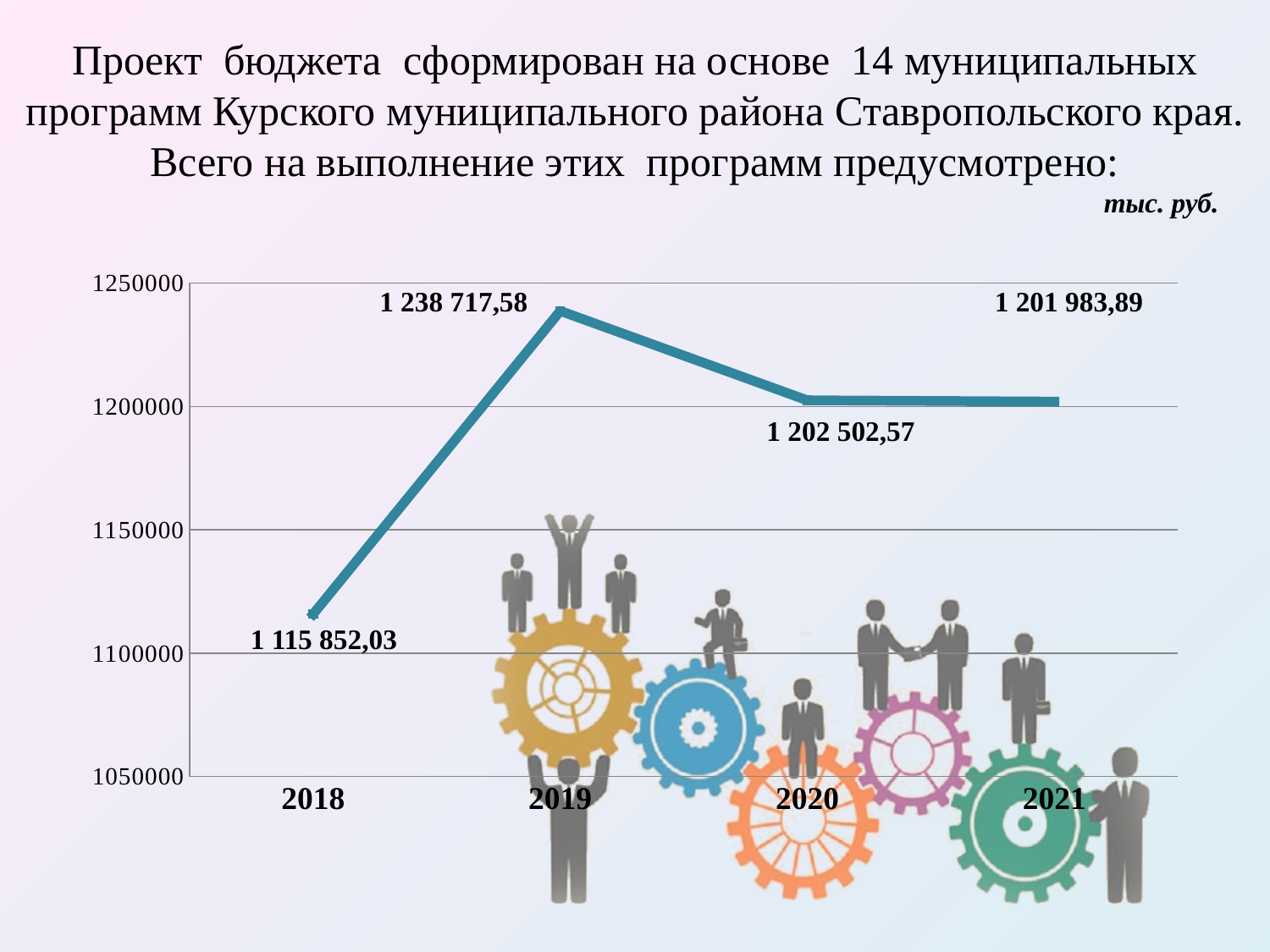
What is the value for 2021? 1 201 983,89 Which year has the lowest value? 2018 What is the value for 2020? 1 202 502,57 Which is larger, the value for 2018 or the value for 2020? 2020 What is the value for 2019? 1 238 717,58 How many years are plotted on the chart? 4 What kind of chart is shown on the slide? line chart What is the difference between the values for 2020 and 2021? 518,68 Which year has the highest value? 2019 What is the difference between the values for 2019 and 2018? 122 865,55 Is the value for 2018 greater or less than 1150000? less What is the value for 2018? 1 115 852,03